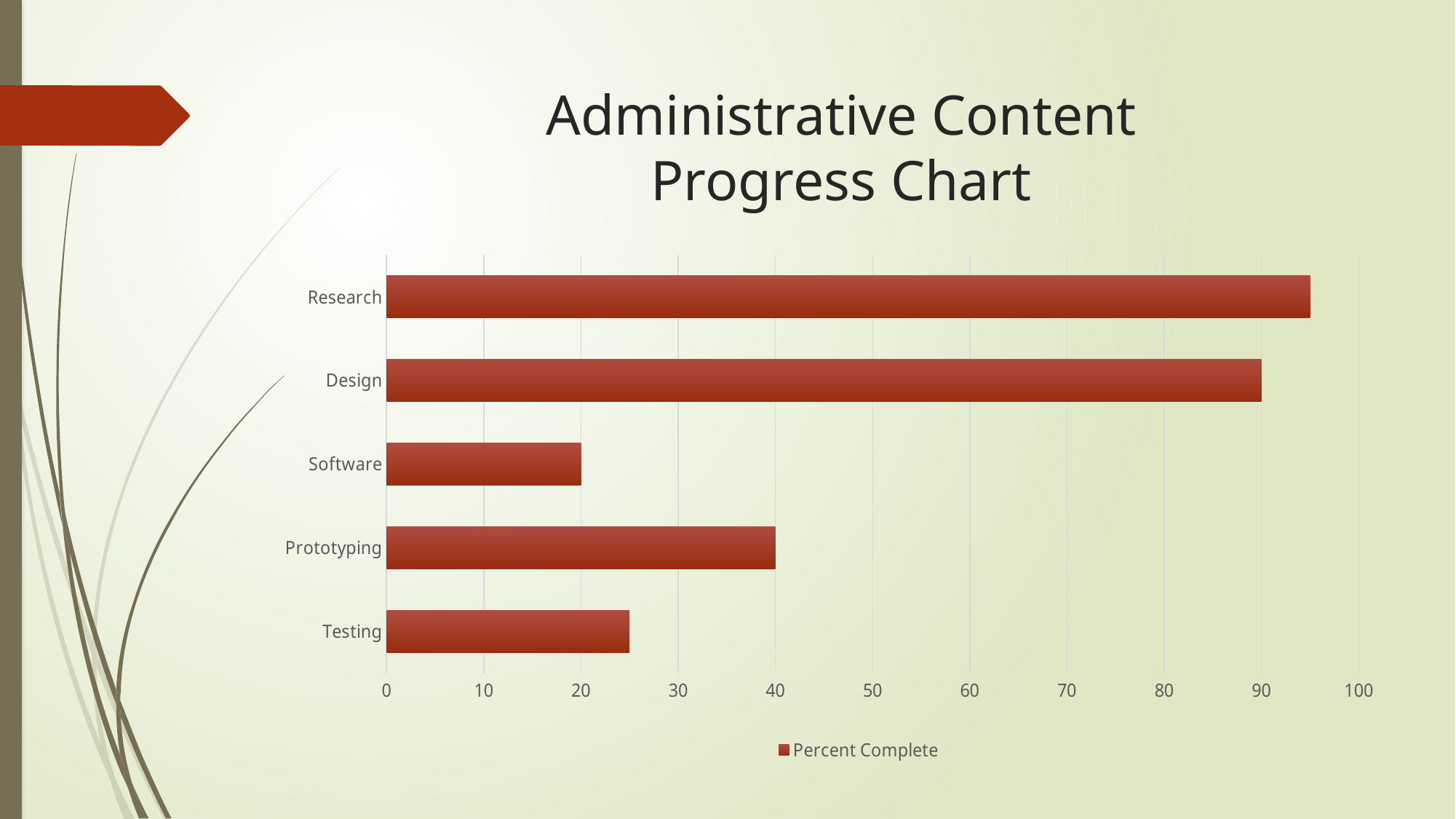
What is the Percent Complete value for Design? 90 What is the Percent Complete value for Prototyping? 40 What type of chart is shown on the slide? bar chart Is the Percent Complete value for Research greater or less than 90? greater Which category has the highest Percent Complete? Research Which category has the lowest Percent Complete? Software What is the title of the chart? Administrative Content Progress Chart What is the Percent Complete value for Software? 20 How many series does the legend list? 1 How many categories are shown on the chart? 5 What is the difference between the Percent Complete values for Design and Prototyping? 50 What is the name of the series shown in the legend? Percent Complete